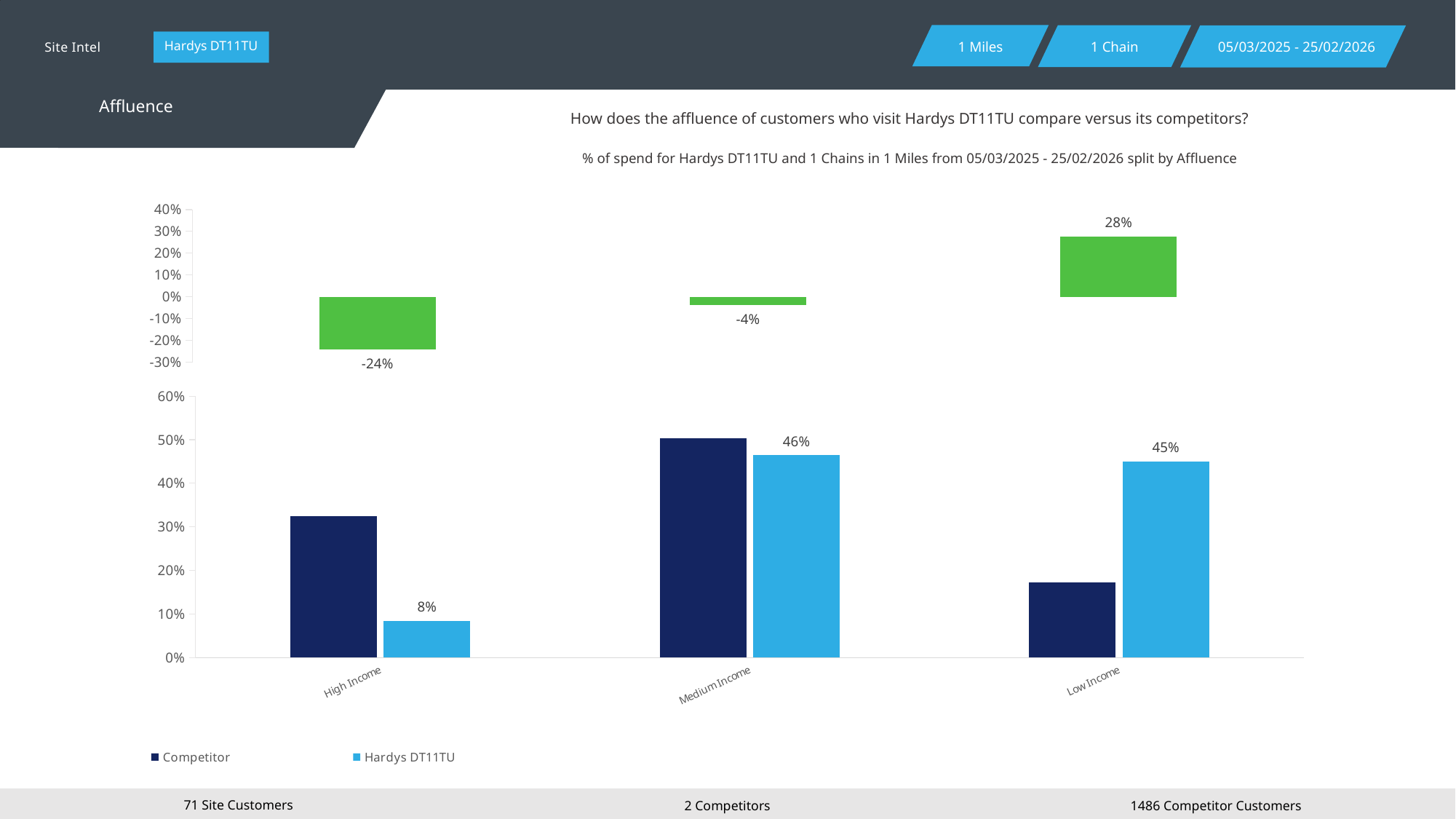
In the bottom chart, what is the value for Hardys DT11TU in the Low Income category? 45% How many series does the legend of the bottom chart list? 2 In the bottom chart, what is the value for Hardys DT11TU in the Medium Income category? 46% In the bottom chart, which category has the lowest value for Hardys DT11TU? High Income In the bottom chart, is the Competitor value for Low Income greater or less than 20%? less In the bottom chart, what is the value for Hardys DT11TU in the High Income category? 8% How many categories are shown on the x axis of the bottom chart? 3 In the top chart, what is the value of the leftmost green bar? -24% In the bottom chart, is the Competitor value for High Income greater or less than 20%? greater In the bottom chart, for the High Income category, which is larger: Competitor or Hardys DT11TU? Competitor In the bottom chart, what is the difference between the Hardys DT11TU values for Medium Income and High Income? 38% In the top chart, what is the value of the rightmost green bar? 28%